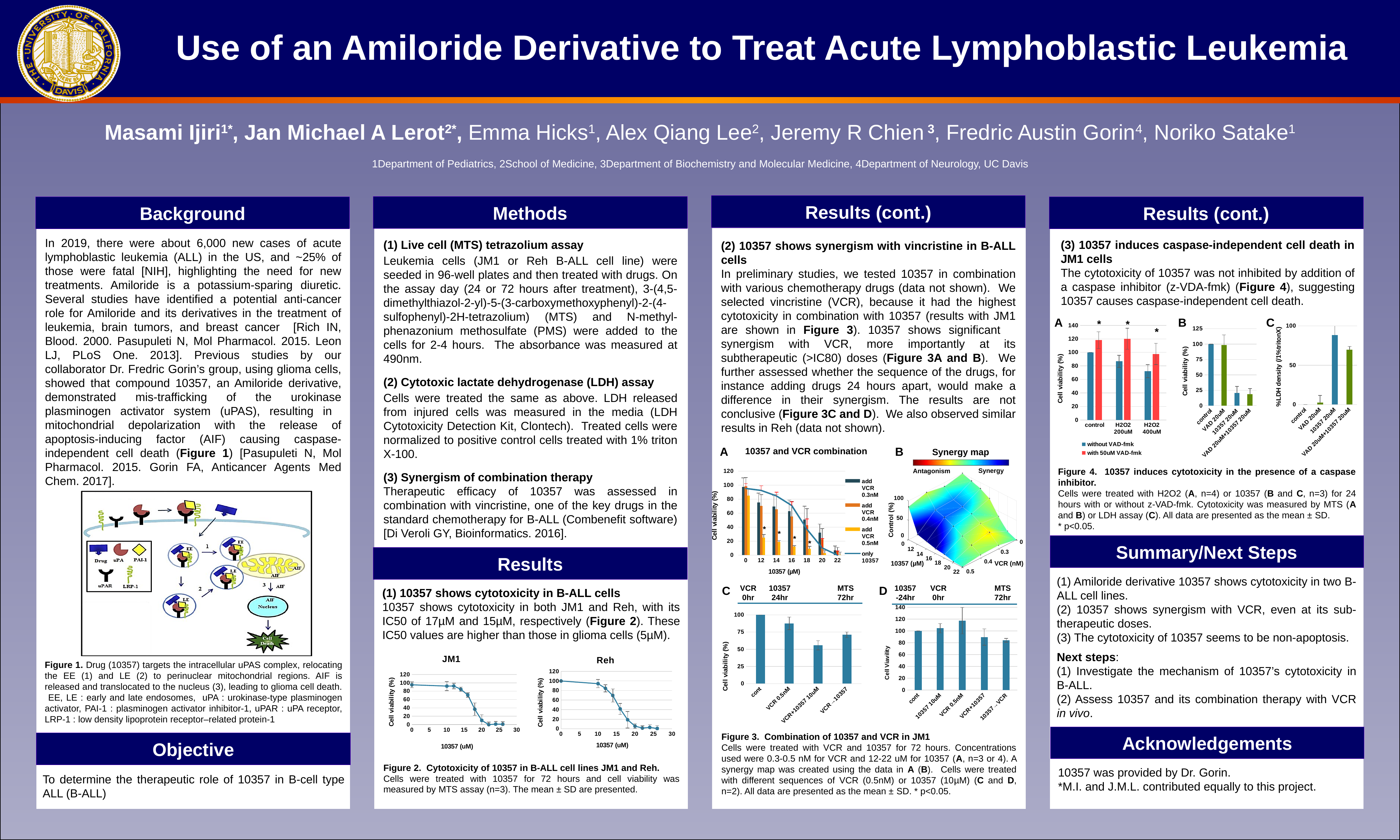
In the Figure 3D bar chart, how many categories are shown on the x axis? 5 In the Figure 4C bar chart, which category has the highest %LDH density? 10357 20uM In the Figure 2 Reh chart, does cell viability rise or fall as the 10357 concentration increases? fall In the Figure 3C bar chart, how many bars are plotted? 4 In the Figure 4B bar chart, is the value for 10357 20uM greater or less than 50? less In the Figure 3D bar chart, is the value for VCR 0.5nM greater or less than 100? greater In the Figure 3C bar chart, which category has the highest cell viability? cont In the Figure 4A bar chart, how many series does the legend list? 2 In the Figure 3A chart titled '10357 and VCR combination', how many series does the legend list? 4 In the Figure 3C bar chart, which category has the lowest cell viability? VCR+10357 10uM In the Figure 2 JM1 chart, what kind of chart is it? line chart In the Figure 4A bar chart, for H2O2 400uM, which is larger: the value without VAD-fmk or with 50uM VAD-fmk? with 50uM VAD-fmk